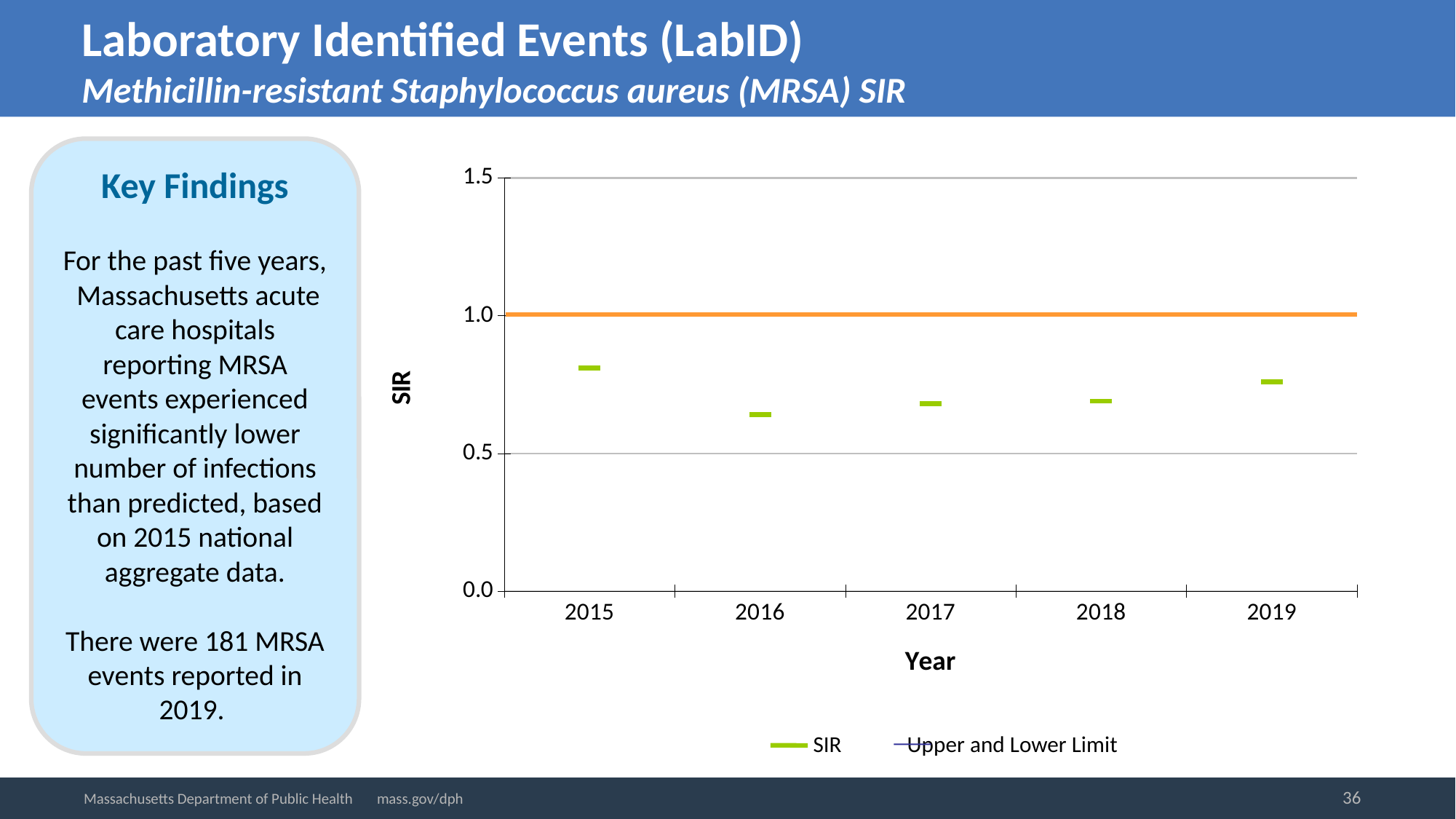
At what value on the SIR axis is the orange 'Upper and Lower Limit' line drawn? 1.0 Which year has a larger SIR value, 2019 or 2016? 2019 How many years are plotted on the x axis of the chart? 5 What is the title of the x axis of the chart? Year Which year has the highest SIR value in the chart? 2015 Is the SIR value for 2016 greater or less than 0.5? greater How many series does the chart legend list? 2 What is the title of the y axis of the chart? SIR Is the SIR value for 2015 greater or less than 1.0? less Is the SIR value for 2019 greater or less than 1.0? less Which year has a larger SIR value, 2015 or 2016? 2015 Which year has the lowest SIR value in the chart? 2016